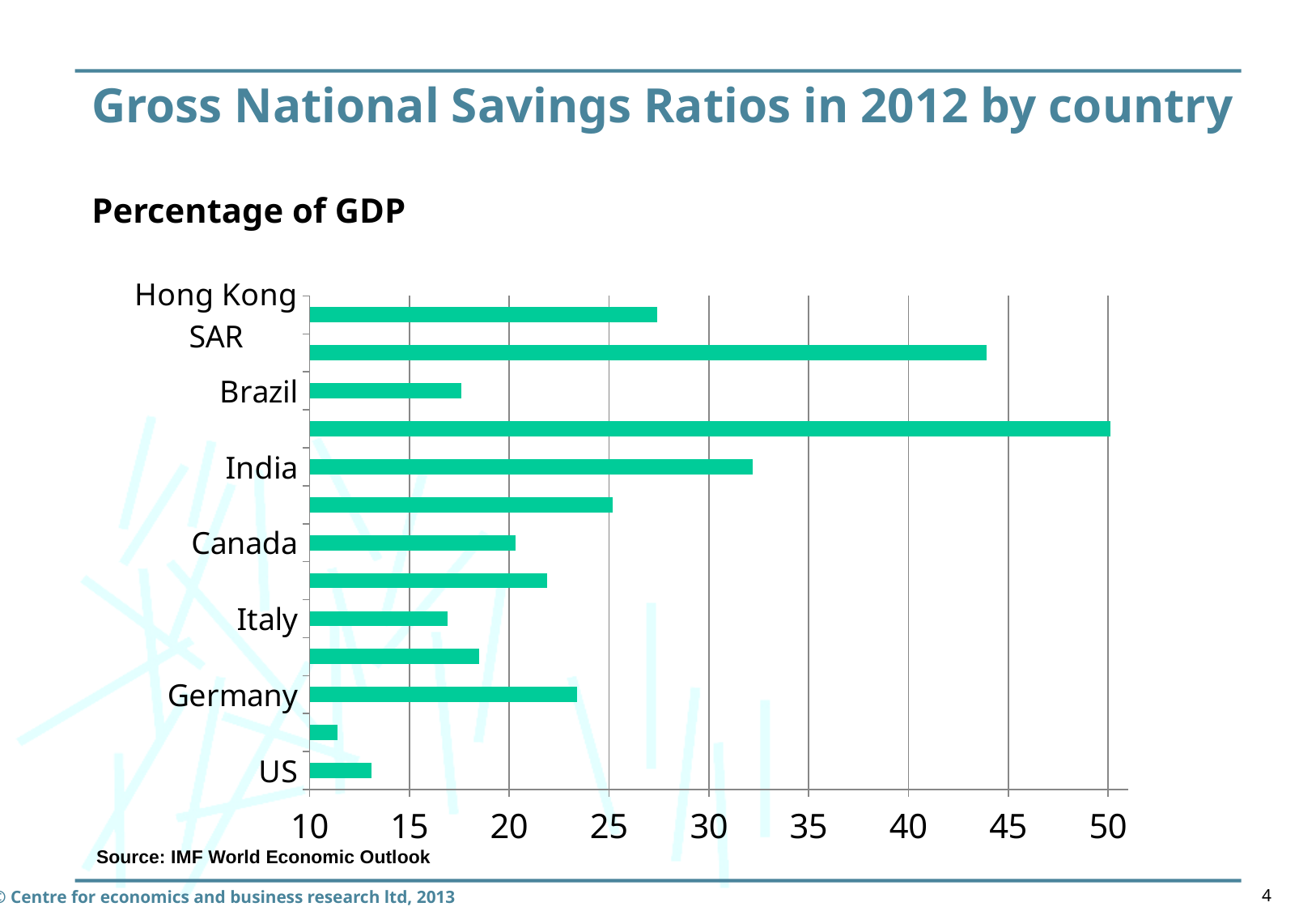
What is the title of the chart on the slide? Gross National Savings Ratios in 2012 by country What is the source cited for the chart? IMF World Economic Outlook Which has the larger value, Germany or Italy? Germany Is the value for US greater or less than 15? less Is the value for India greater or less than 30? greater Which has the larger value, India or Canada? India Among the labelled countries, which has the lowest value? US What kind of chart is shown on the slide? bar chart Is the value for Canada greater or less than 25? less How many bars are plotted in the chart? 13